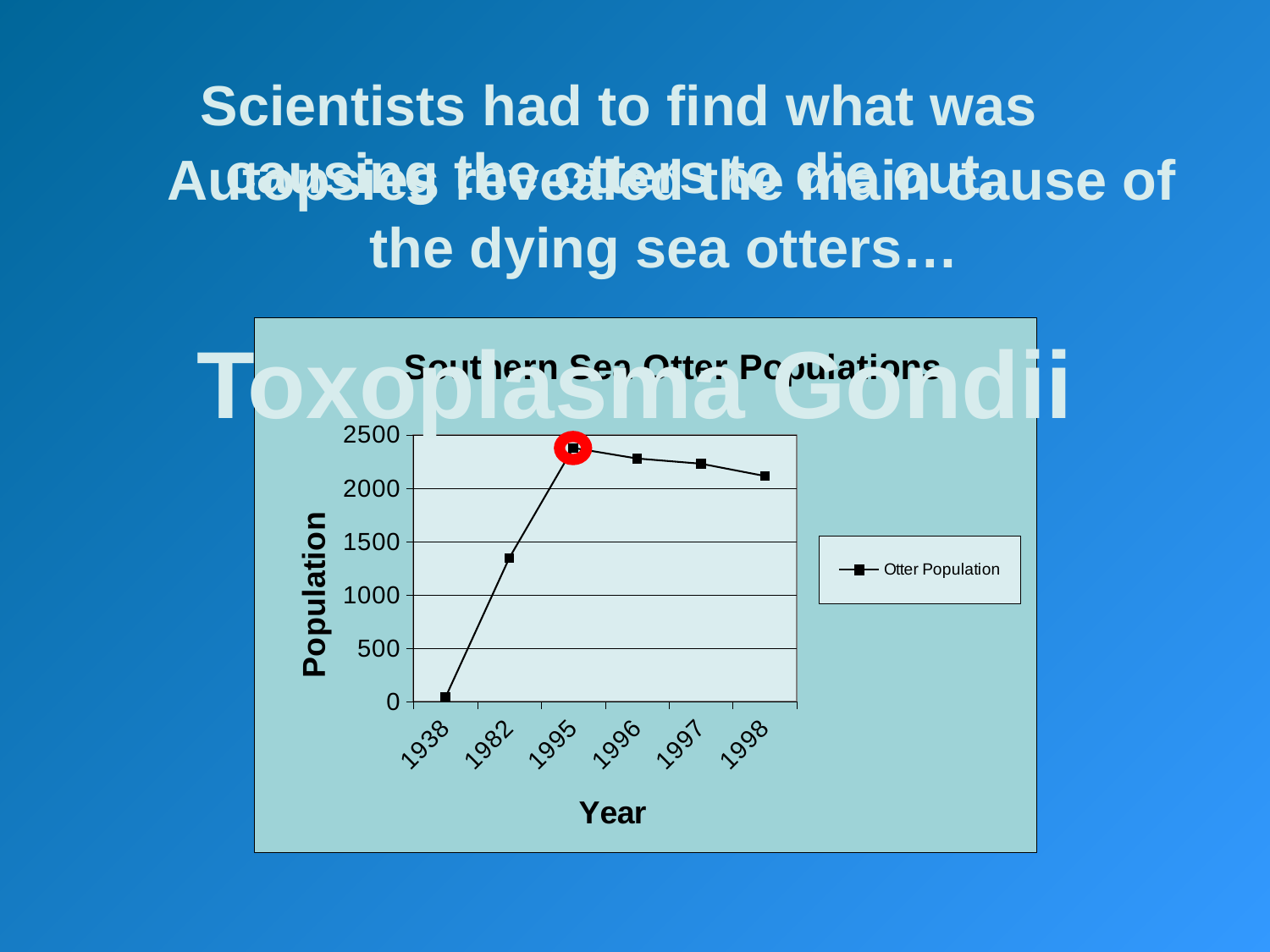
What is the label of the y axis of the chart? Population Does the otter population rise or fall from 1995 to 1998? fall What kind of chart is shown on the slide? line chart Is the otter population for 1982 greater or less than 1000? greater What series name is shown in the chart's legend? Otter Population Which year has the lowest otter population in the chart? 1938 How many years are plotted on the x axis of the chart? 6 Is the otter population for 1998 greater or less than 2000? greater Which year has the highest otter population in the chart? 1995 Is the otter population for 1938 greater or less than 500? less Which year has the larger otter population, 1982 or 1995? 1995 How many series does the chart's legend list? 1